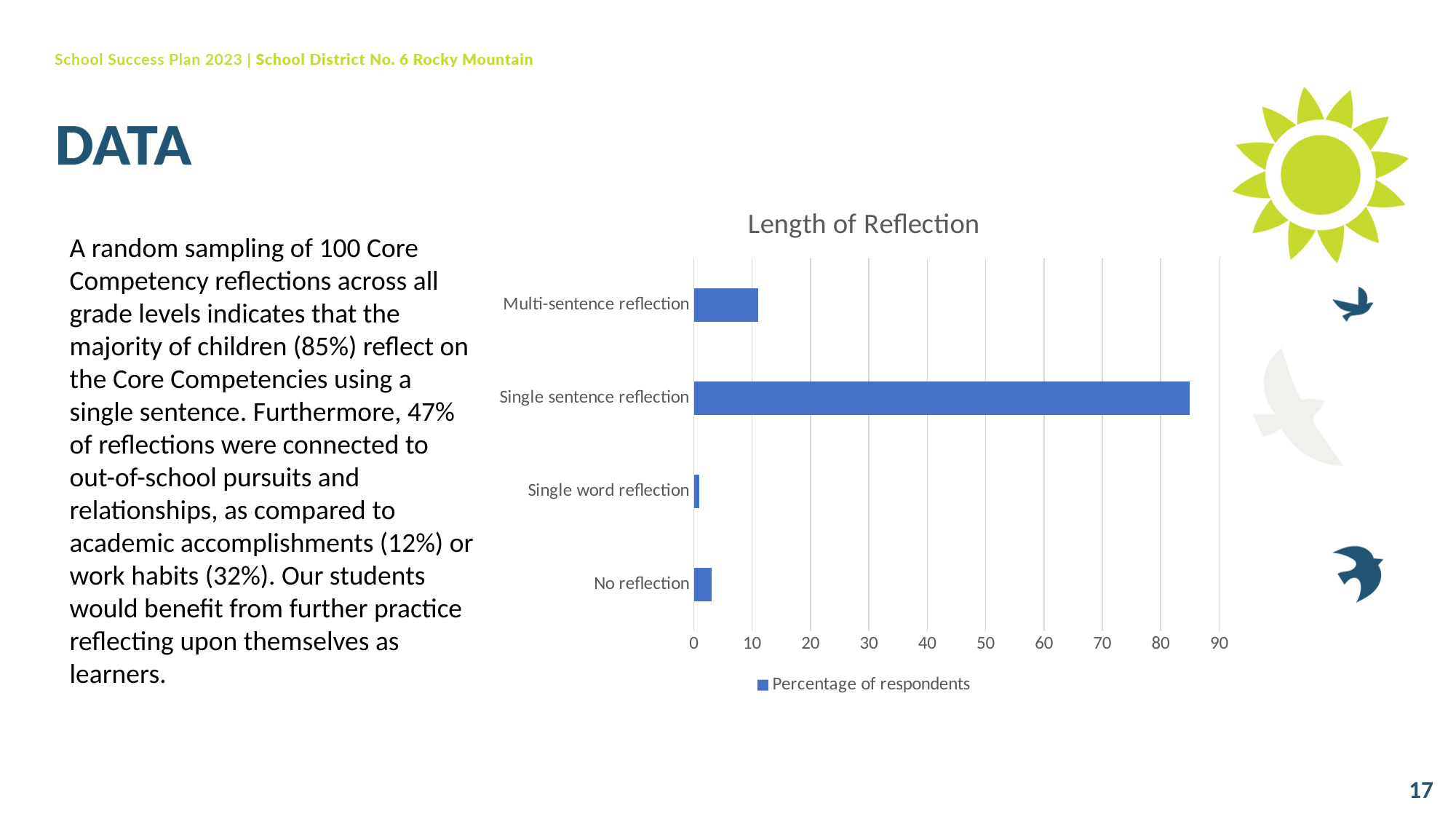
What kind of chart is shown on the slide? bar chart What series name is shown in the chart legend? Percentage of respondents Which is larger, the value for Single sentence reflection or the value for Multi-sentence reflection? Single sentence reflection Is the value for Multi-sentence reflection greater or less than 20? less How many series does the chart legend list? 1 Which category has the highest value in the chart? Single sentence reflection Is the value for No reflection greater or less than 10? less Which is larger, the value for Multi-sentence reflection or the value for No reflection? Multi-sentence reflection What is the title of the chart? Length of Reflection Is the value for Single sentence reflection greater or less than 80? greater Which category has the lowest value in the chart? Single word reflection How many categories are plotted in the chart? 4